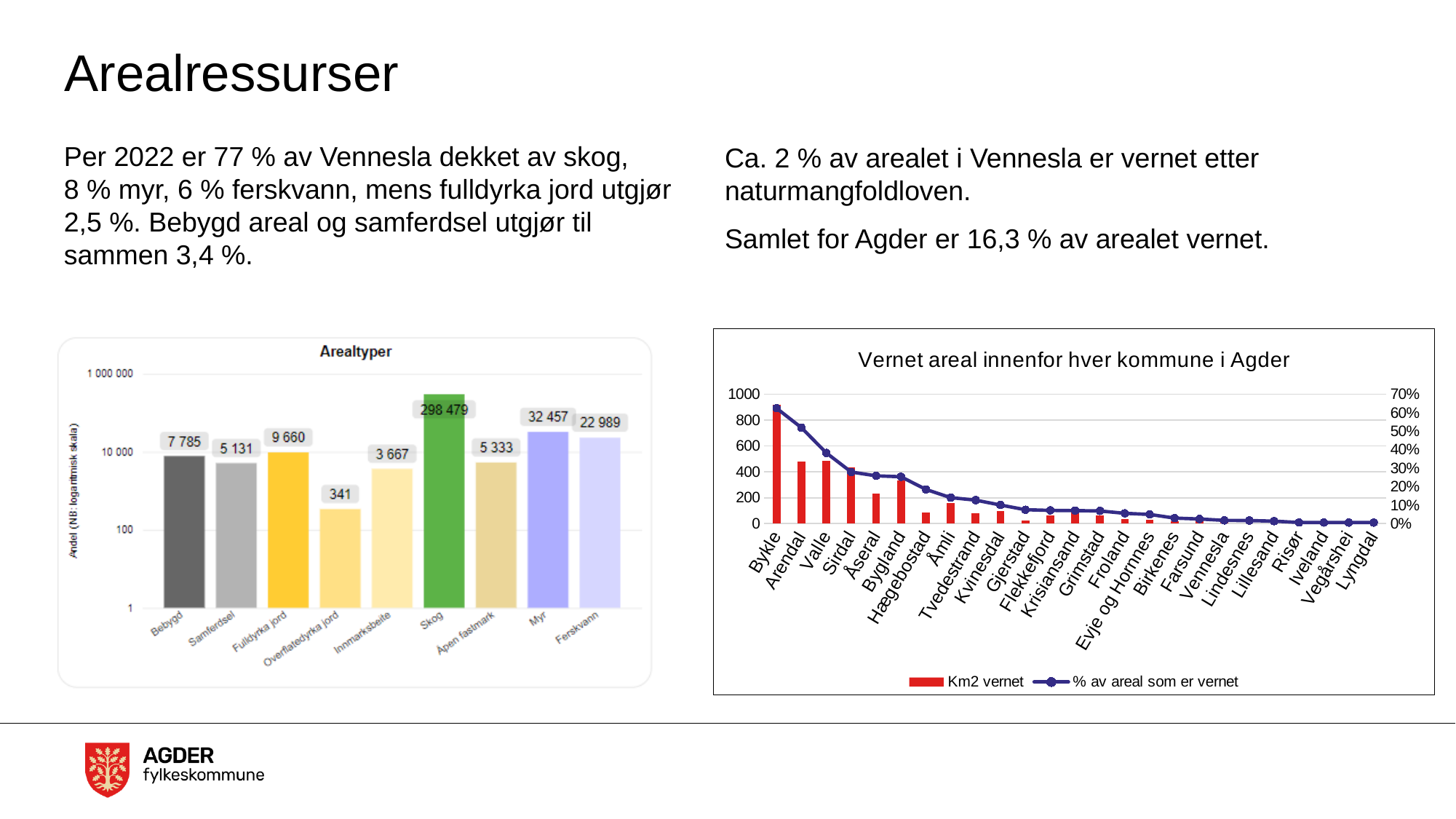
In the Arealtyper chart, what is the value for Skog? 298 479 In the chart 'Vernet areal innenfor hver kommune i Agder', which municipality has the highest Km2 vernet? Bykle How many series does the legend list in the chart 'Vernet areal innenfor hver kommune i Agder'? 2 In the Arealtyper chart, what is the difference between Myr and Ferskvann? 9 468 In the Arealtyper chart, what is the value for Overflatedyrka jord? 341 In the Arealtyper chart, which is larger, Bebygd or Samferdsel? Bebygd In the Arealtyper chart, which category has the lowest value? Overflatedyrka jord In the Arealtyper chart, what is the value for Myr? 32 457 In the chart 'Vernet areal innenfor hver kommune i Agder', is the Km2 vernet value for Arendal greater or less than 400? greater How many categories are shown in the Arealtyper chart? 9 In the Arealtyper chart, which category has the highest value? Skog In the chart 'Vernet areal innenfor hver kommune i Agder', does the '% av areal som er vernet' line rise or fall from left to right? fall